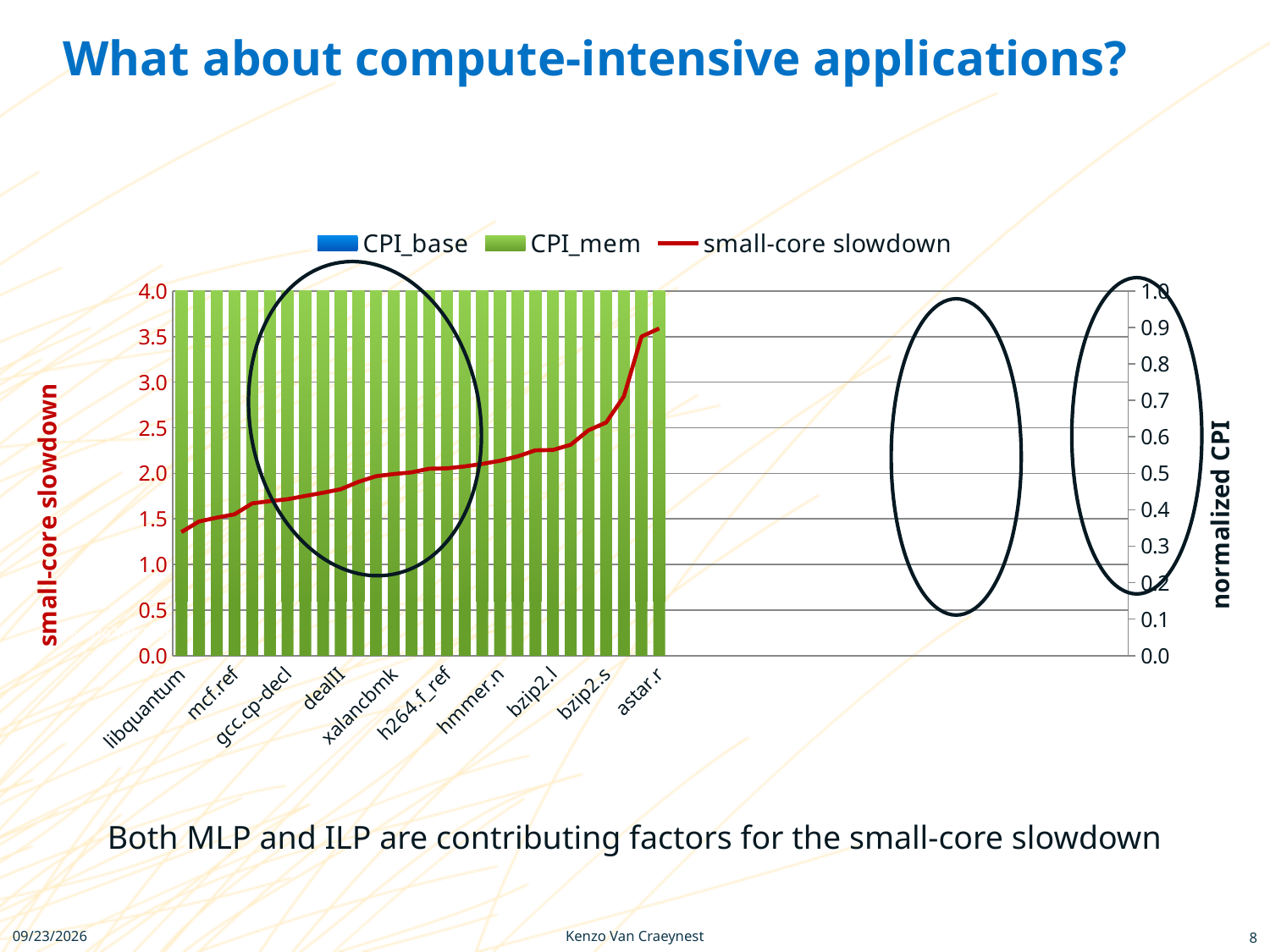
Is the small-core slowdown for astar.r greater or less than 3.0? greater Which labelled benchmark has the lowest small-core slowdown? libquantum How many series does the chart legend list? 3 Which has the larger small-core slowdown, bzip2.s or mcf.ref? bzip2.s What is the title of the left vertical axis? small-core slowdown Is the small-core slowdown for libquantum greater or less than 2.0? less Which labelled benchmark has the highest small-core slowdown? astar.r Is the small-core slowdown for hmmer.n greater or less than 2.5? less What is the title of the right vertical axis? normalized CPI What kind of chart is shown on the slide? A bar chart combined with a line Does the small-core slowdown line rise or fall from left to right along the x axis? It rises